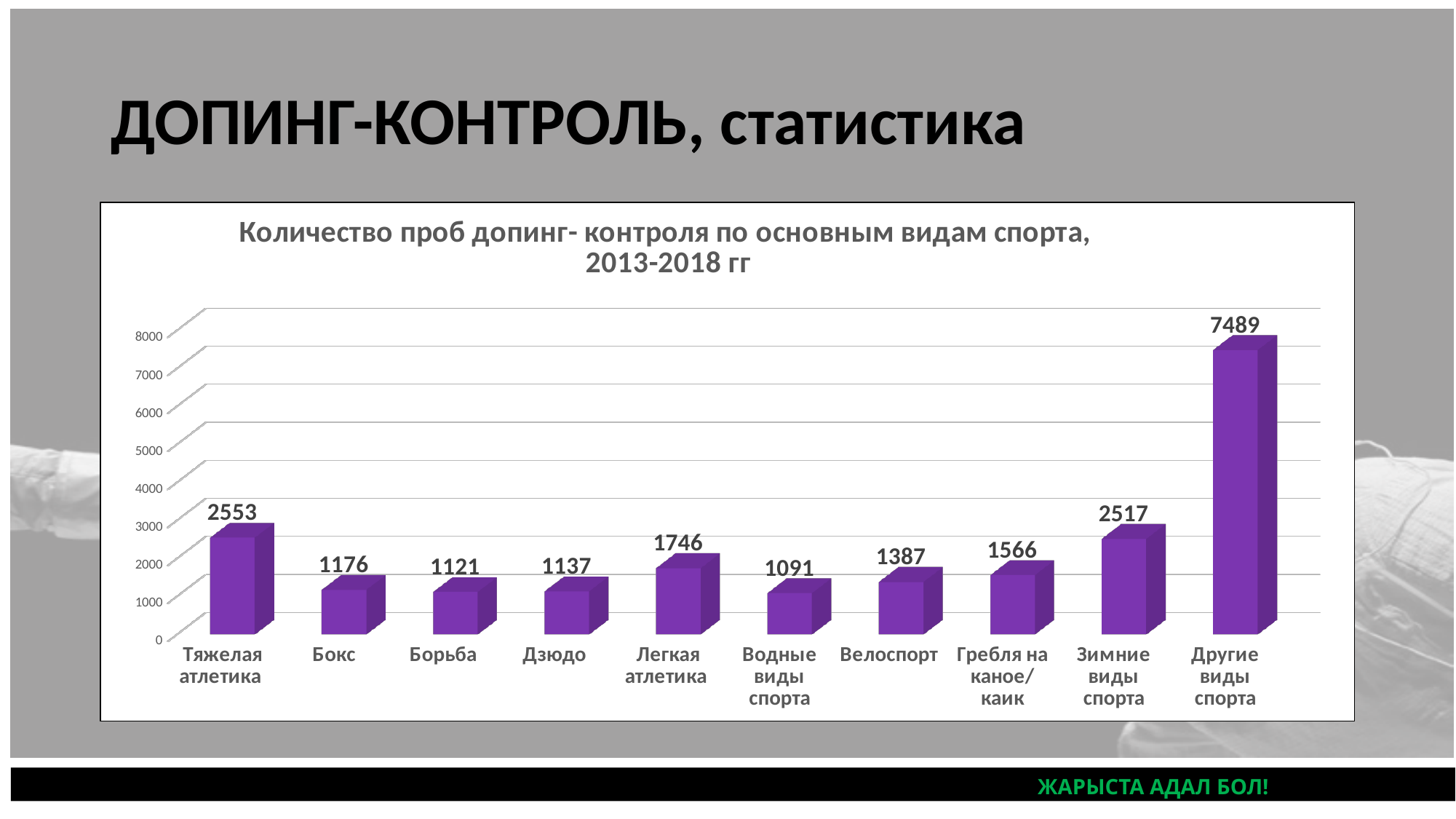
Which category has the lowest value? Водные виды спорта Which is larger, the value for Велоспорт or the value for Дзюдо? Велоспорт What is the difference between the values for Тяжелая атлетика and Легкая атлетика? 807 What kind of chart is shown? bar chart What colour are the bars in the chart? purple What is the value for Гребля на каное/каик? 1566 What is the value for Зимние виды спорта? 2517 Which category has the highest value? Другие виды спорта What is the value for Бокс? 1176 Is the value for Другие виды спорта greater or less than 7000? greater What is the title of the chart? Количество проб допинг- контроля по основным видам спорта, 2013-2018 гг How many categories are shown on the x axis? 10